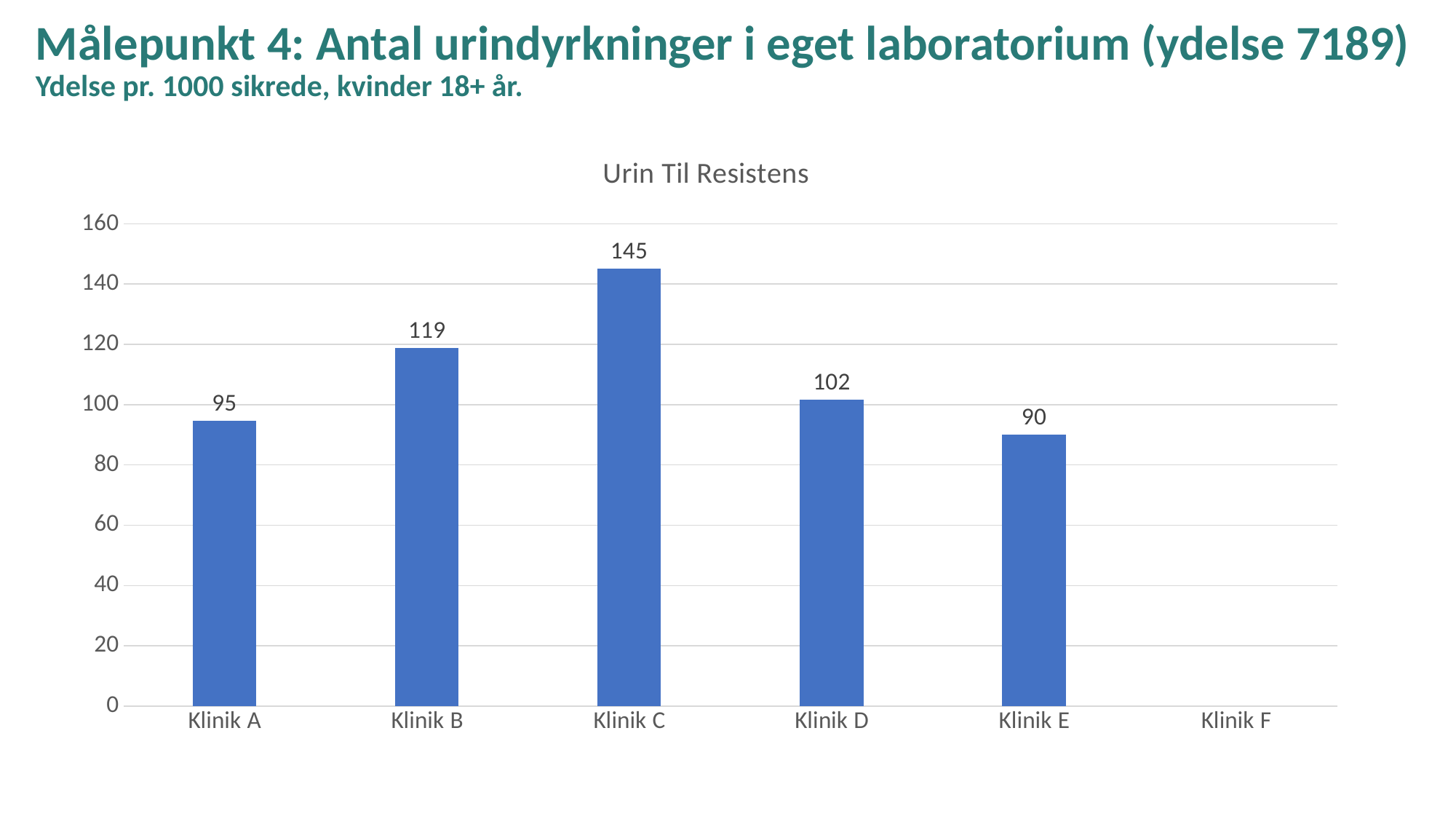
What is the value for Klinik E? 90 What kind of chart is shown on the slide? bar chart Which clinic has no bar plotted in the chart? Klinik F What is the difference between the values for Klinik D and Klinik E? 12 Is the value for Klinik A greater or less than 100? less Which clinic has the highest value? Klinik C What is the value for Klinik C? 145 What is the title of the chart? Urin Til Resistens What is the difference between the values for Klinik C and Klinik B? 26 How many clinic categories are labelled on the x axis? 6 Which is larger, the value for Klinik B or the value for Klinik D? Klinik B What is the value for Klinik A? 95